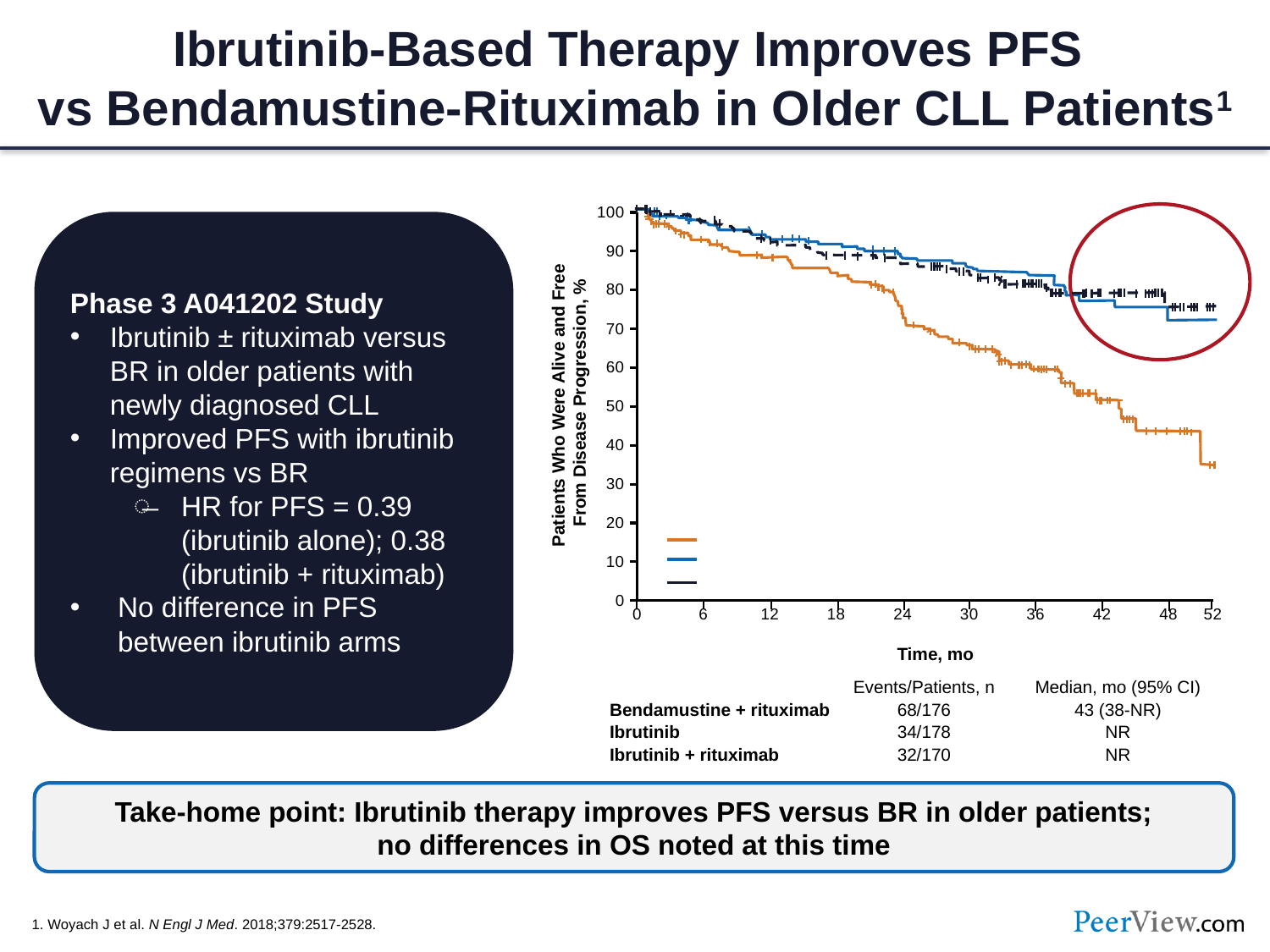
What is the Events/Patients value for Ibrutinib in the table below the chart? 34/178 What is the label of the y axis of the chart? Patients Who Were Alive and Free From Disease Progression, % What is the median PFS reported for the Ibrutinib arm? NR Do the curves rise or fall as time increases along the x axis? fall What is the median PFS in months (95% CI) for Bendamustine + rituximab? 43 (38-NR) Which arm has the highest number of events in the table? Bendamustine + rituximab What is the label of the x axis of the chart? Time, mo What kind of chart is shown on the slide? line chart How many series (curves) are shown in the chart legend? 3 What is the Events/Patients value for Ibrutinib + rituximab in the table below the chart? 32/170 Is the value of the orange curve at 48 months greater or less than 50? less What is the Events/Patients value for Bendamustine + rituximab in the table below the chart? 68/176